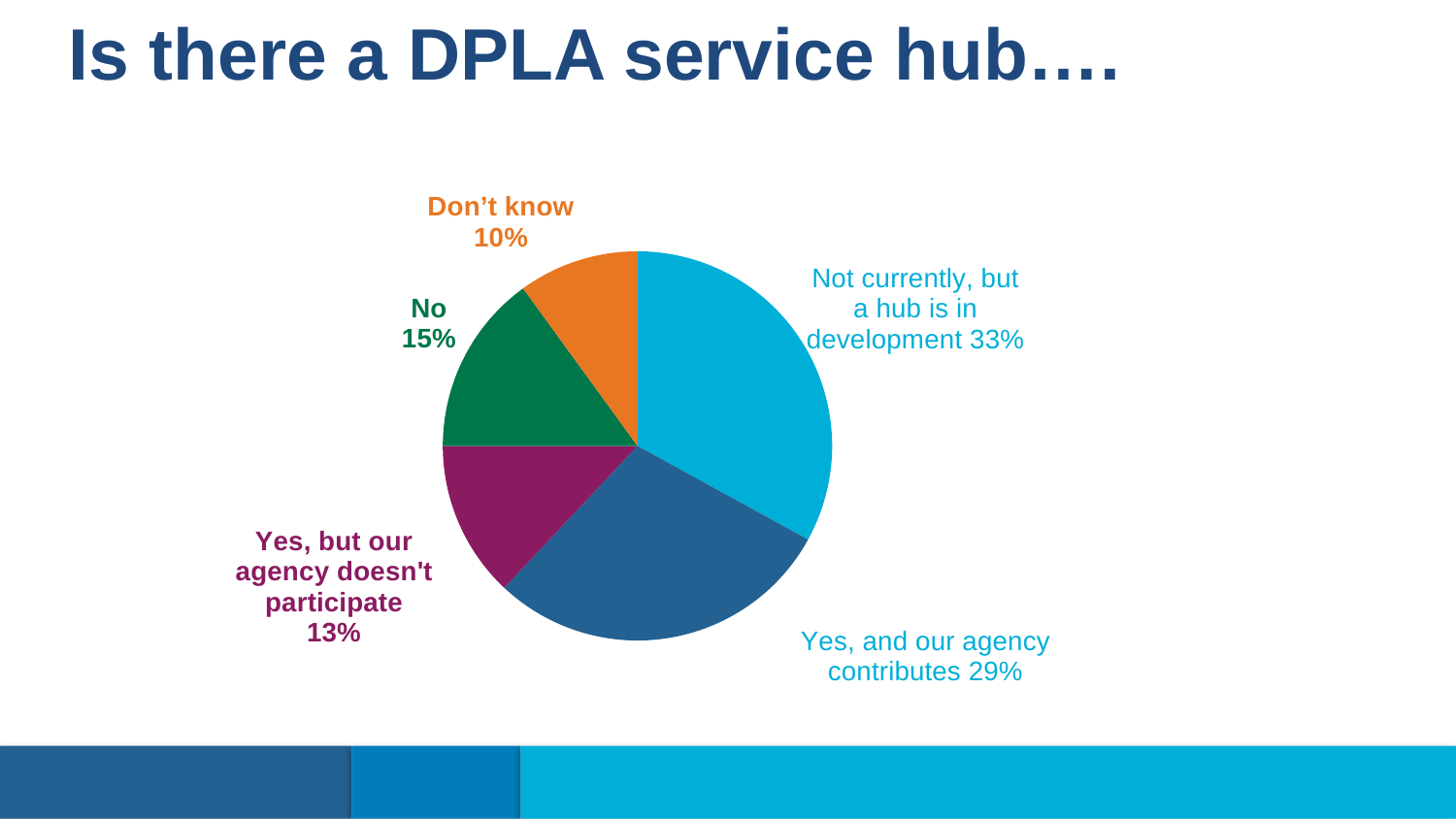
What is the difference between the 'Not currently, but a hub is in development' share and the 'Yes, and our agency contributes' share? 4% What is the title of the slide containing the pie chart? Is there a DPLA service hub…. What share of the pie is 'Yes, but our agency doesn't participate'? 13% What share of the pie is 'Yes, and our agency contributes'? 29% What kind of chart is shown on the slide? pie chart Which slice of the pie is the largest? Not currently, but a hub is in development Which is larger, the 'No' share or the 'Yes, but our agency doesn't participate' share? No How many slices does the pie chart have? 5 What share of the pie is 'No'? 15% Which slice of the pie is the smallest? Don't know